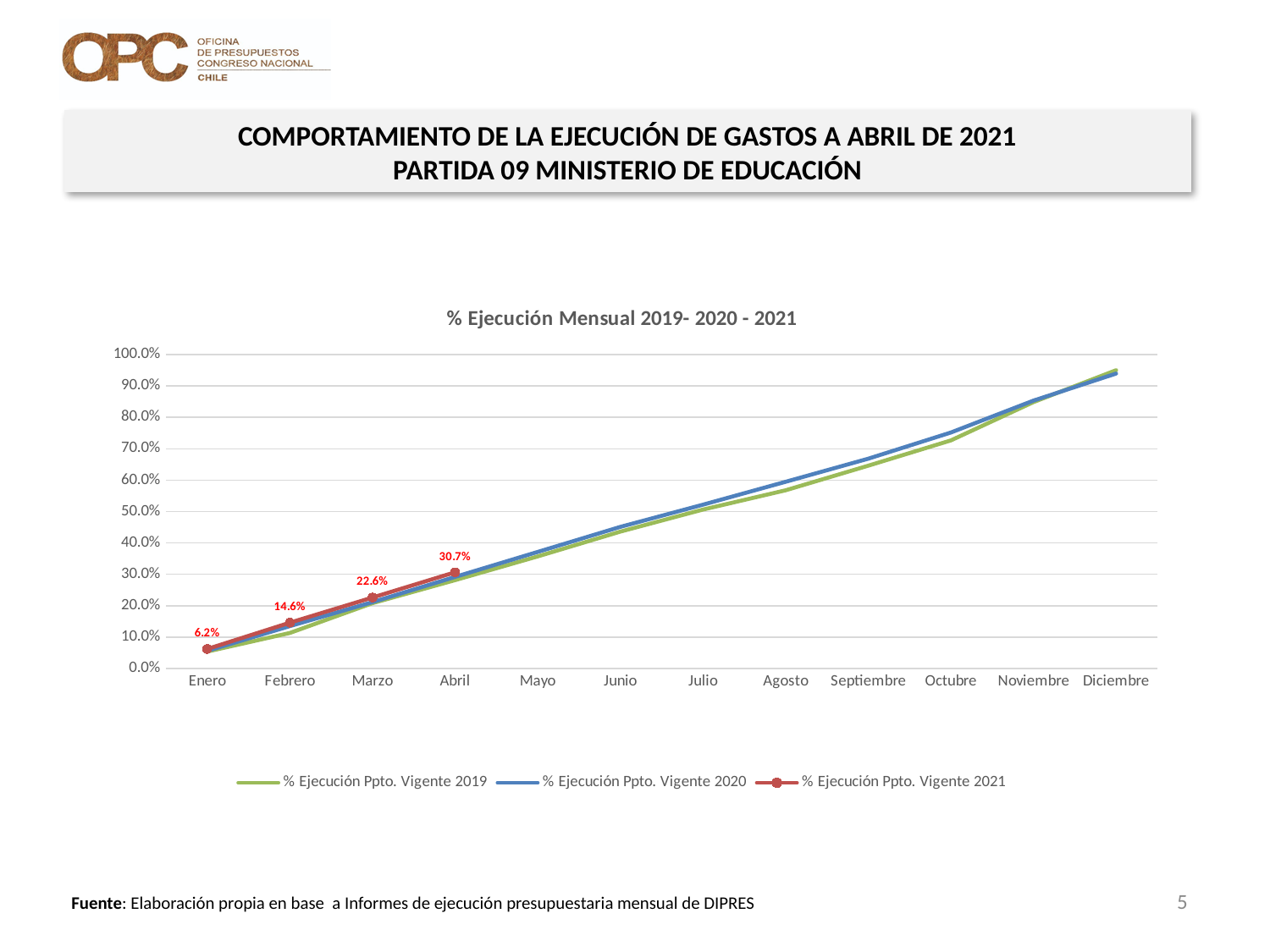
How many months are shown on the x axis? 12 What kind of chart is shown on the slide? Line chart What is the title of the chart? % Ejecución Mensual 2019- 2020 - 2021 Is the value for Diciembre in the % Ejecución Ppto. Vigente 2020 series greater or less than 90.0%? greater Do the values of the % Ejecución Ppto. Vigente 2019 series rise or fall from Enero to Diciembre? Rise What is the value for Marzo in the % Ejecución Ppto. Vigente 2021 series? 22.6% What is the difference between the Abril and Marzo values in the % Ejecución Ppto. Vigente 2021 series? 8.1% What is the value for Febrero in the % Ejecución Ppto. Vigente 2021 series? 14.6% How many series does the legend list? 3 What is the value for Abril in the % Ejecución Ppto. Vigente 2021 series? 30.7% What is the value for Enero in the % Ejecución Ppto. Vigente 2021 series? 6.2% Which month has the highest labelled value in the % Ejecución Ppto. Vigente 2021 series? Abril